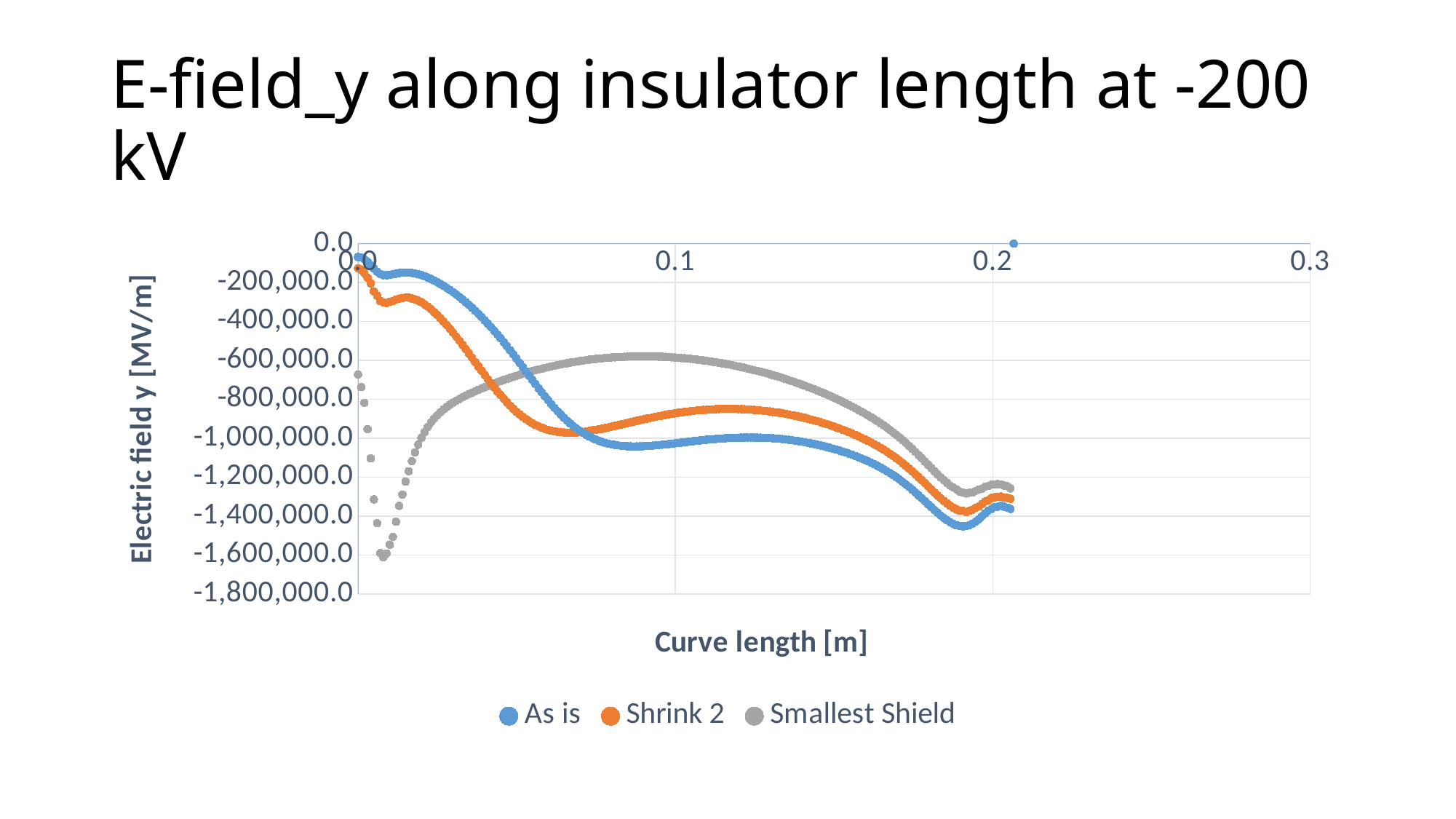
How many series does the legend list? 3 Does the Smallest Shield series rise or fall between curve lengths of 0.02 m and 0.1 m? rise Is the value for As is at a curve length of 0.05 m greater or less than -800,000.0? greater At a curve length of 0.1 m, which series has the lower value, As is or Shrink 2? As is Which series reaches the lowest value on the chart? Smallest Shield Is the value for Smallest Shield at a curve length of 0.1 m greater or less than -800,000.0? greater Does the As is series rise or fall overall between curve lengths of 0.1 m and 0.2 m? fall What kind of chart is shown on the slide? Scatter chart What is the label of the x axis? Curve length [m] At a curve length of 0.1 m, which series has the higher value, Smallest Shield or As is? Smallest Shield What is the title of the chart? E-field_y along insulator length at -200 kV Is the value for Shrink 2 at a curve length of 0.1 m greater or less than -800,000.0? less